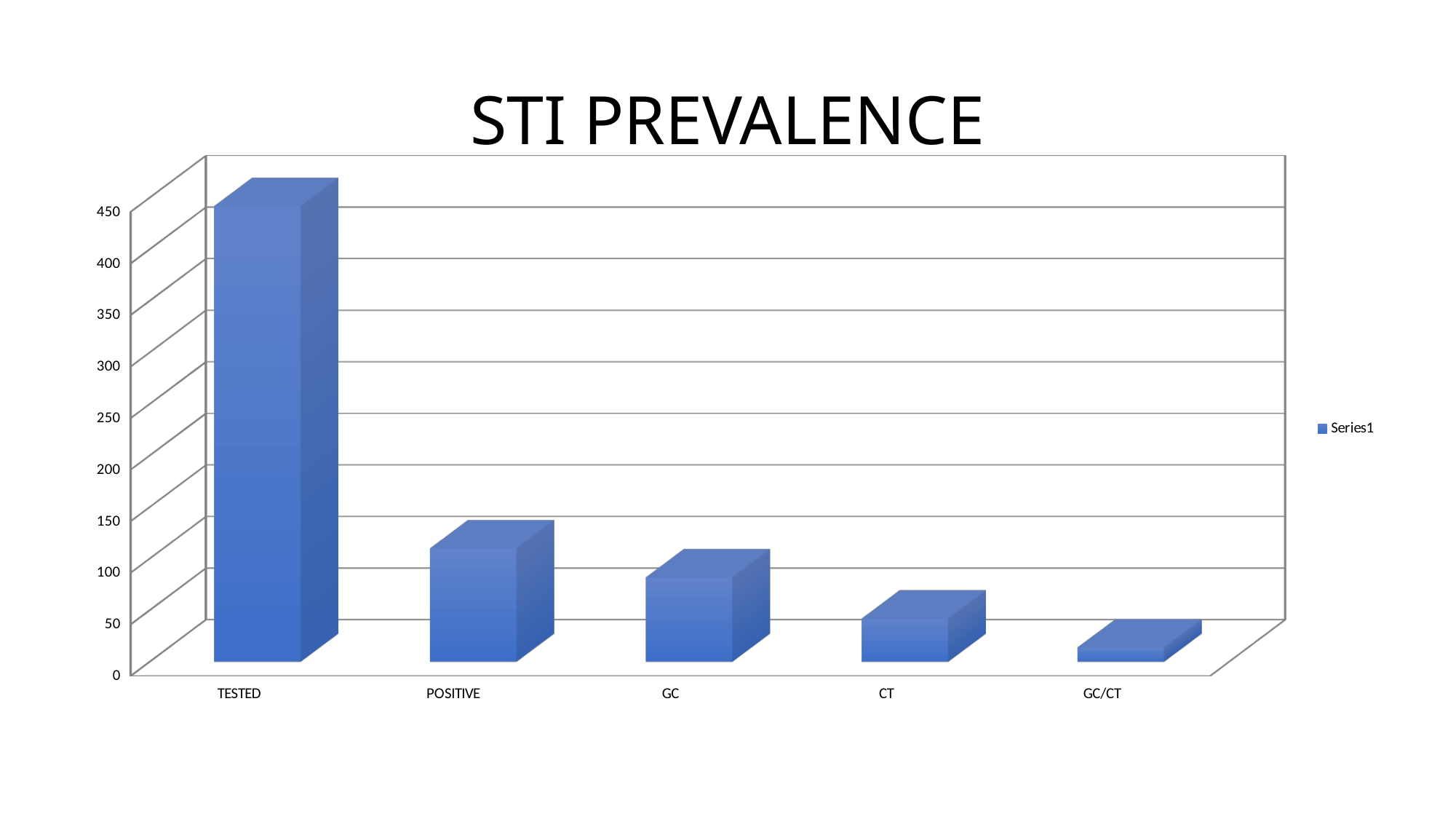
Is the value for POSITIVE greater or less than 150? less Which is larger, the value for GC or the value for CT? GC Which category has the highest value? TESTED Do the values rise or fall moving from left to right along the x axis? fall Which is larger, the value for POSITIVE or the value for GC/CT? POSITIVE Is the value for CT greater or less than 100? less Which category has the lowest value? GC/CT How many series does the legend list? 1 Is the value for TESTED greater or less than 400? greater How many categories are shown on the x axis? 5 What kind of chart is shown on the slide? bar chart What is the title of the chart? STI PREVALENCE